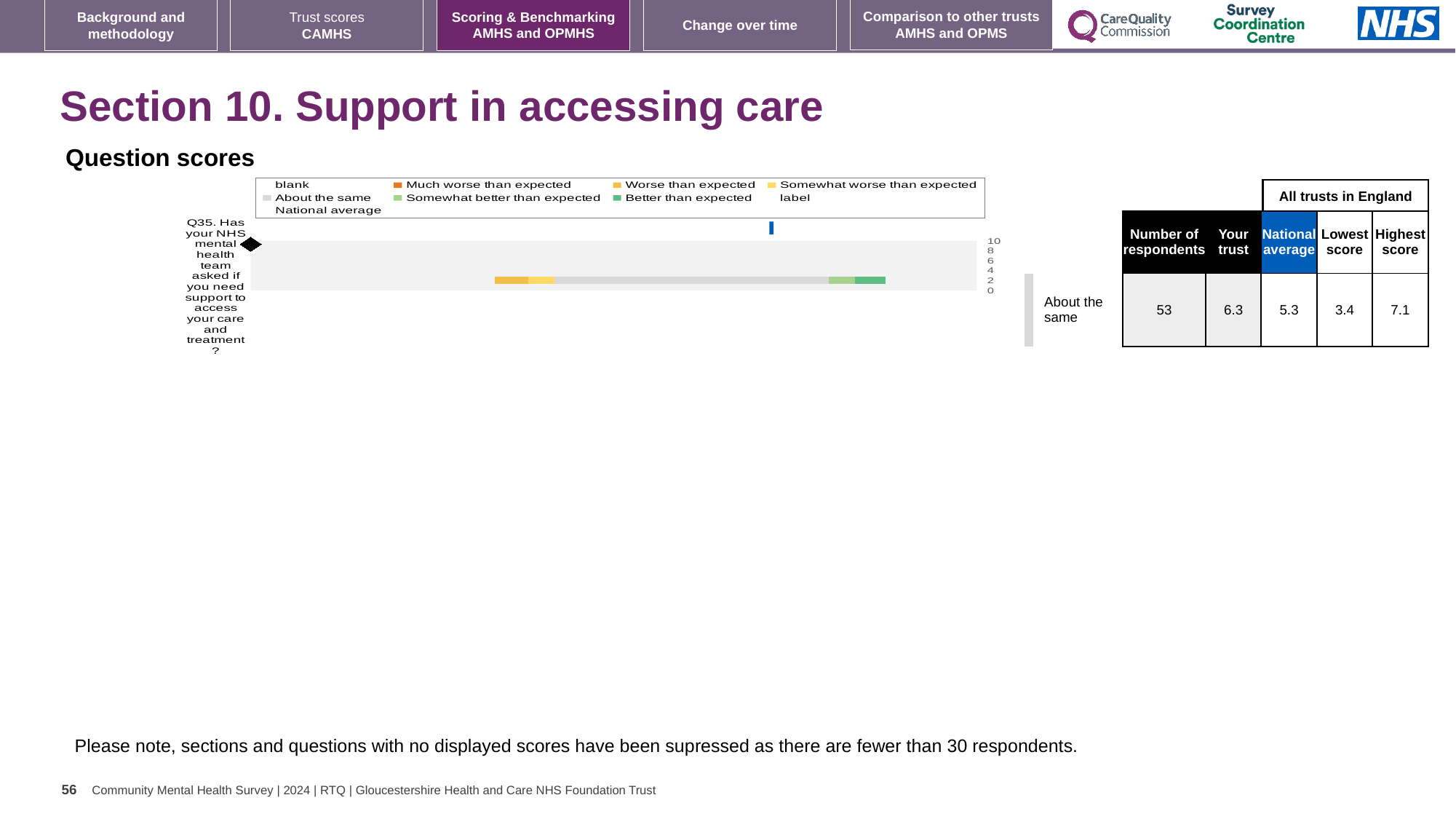
Which is higher for Q35: the trust's score or the national average? Your trust What is the highest score among all trusts in England for Q35? 7.1 What is the national average score for Q35? 5.3 What kind of chart is used to show the Q35 question score? bar chart How many respondents answered Q35? 53 By how much does the trust's score for Q35 exceed the national average? 1.0 What is the 'Your trust' score for Q35 (support to access care and treatment)? 6.3 How many questions are plotted in the Question scores chart? 1 What is the difference between the highest and lowest scores for Q35 across all trusts in England? 3.7 What is the maximum value shown on the chart's score axis? 10 What benchmark category is shown for Q35? About the same What is the lowest score among all trusts in England for Q35? 3.4